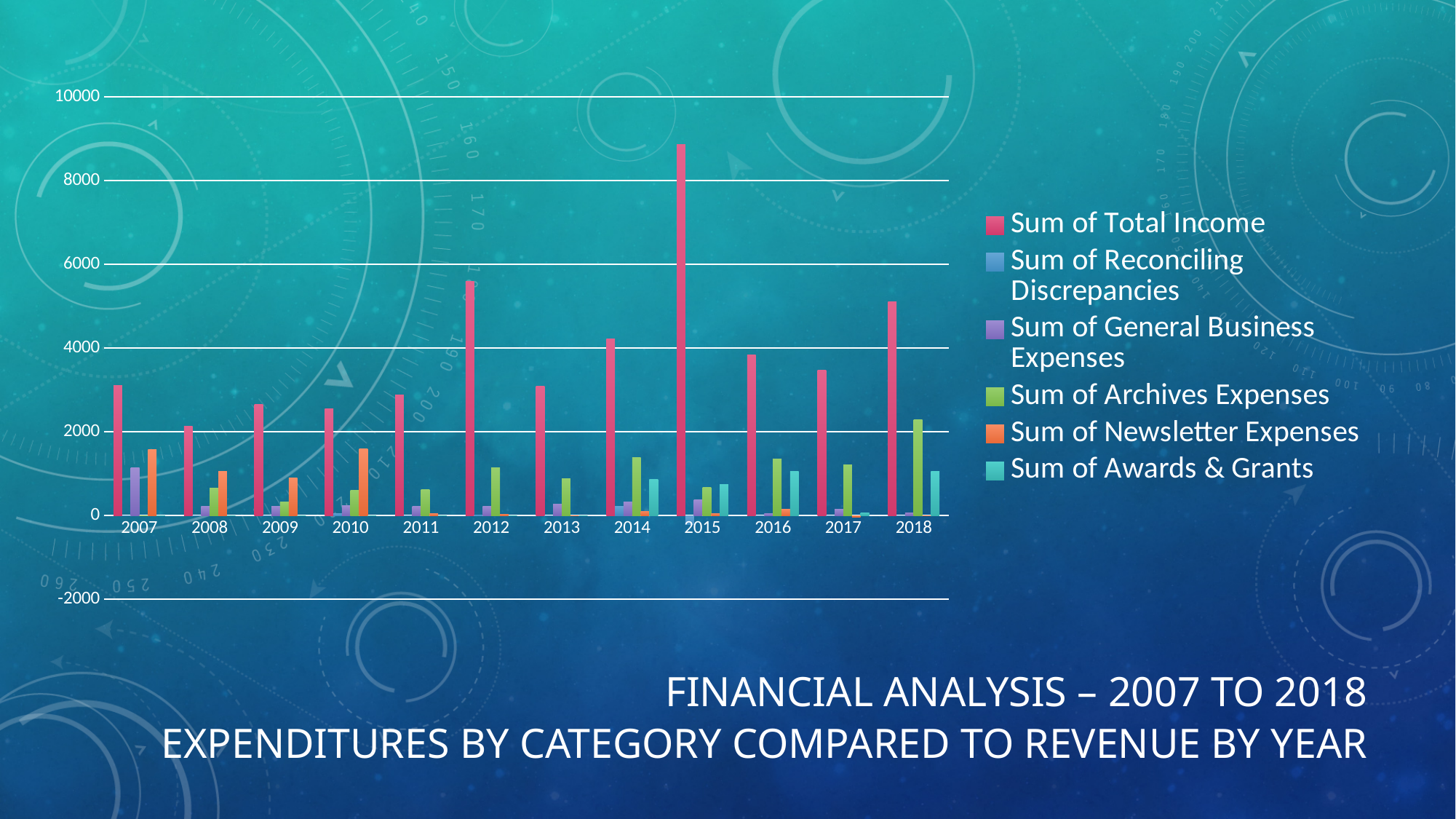
Is the value for Sum of Total Income in 2012 greater or less than 6000? less Which is larger, Sum of Total Income in 2012 or in 2013? 2012 Is the value for Sum of Total Income in 2015 greater or less than 8000? greater What colour represents Sum of Total Income in the chart's legend? Pink What kind of chart is shown on the slide? Bar chart How many years are shown along the x axis of the chart? 12 How many series does the chart's legend list? 6 Which is larger, Sum of Total Income in 2016 or in 2017? 2016 In which year is Sum of Total Income highest? 2015 In which year is Sum of Archives Expenses highest? 2018 Is the value for Sum of Archives Expenses in 2018 greater or less than 2000? greater In which year is Sum of Total Income lowest? 2008